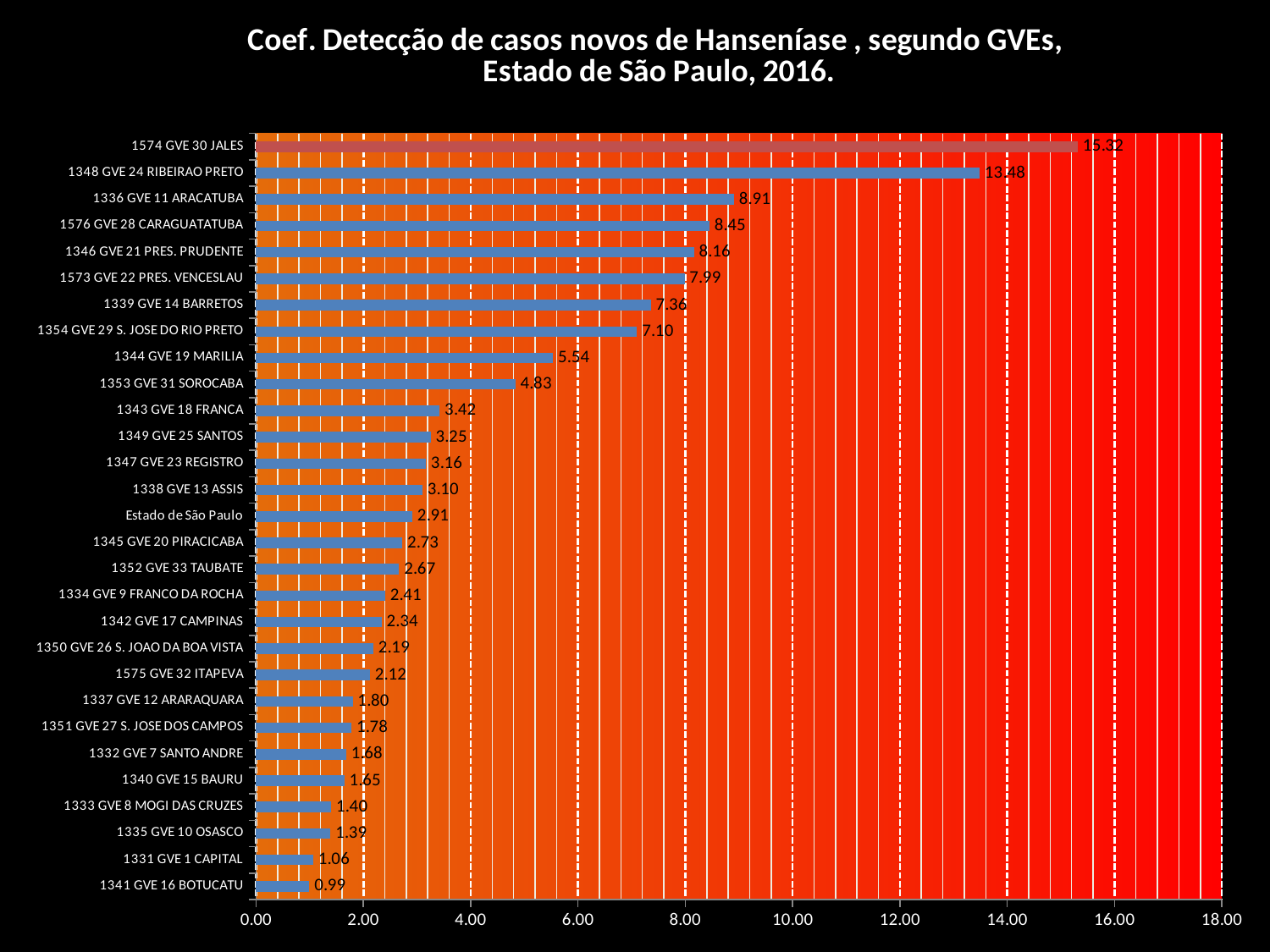
What is the value for 1574 GVE 30 JALES? 15.32 What kind of chart is shown on the slide? bar chart What is the value for Estado de São Paulo? 2.91 How many categories are shown in the chart? 29 Which category has the highest value? 1574 GVE 30 JALES Which category has the lowest value? 1341 GVE 16 BOTUCATU What is the difference between the values for 1574 GVE 30 JALES and 1348 GVE 24 RIBEIRAO PRETO? 1.84 Which is larger, the value for 1336 GVE 11 ARACATUBA or 1576 GVE 28 CARAGUATATUBA? 1336 GVE 11 ARACATUBA What is the difference between the values for 1331 GVE 1 CAPITAL and 1341 GVE 16 BOTUCATU? 0.07 What is the title of the chart? Coef. Detecção de casos novos de Hanseníase , segundo GVEs, Estado de São Paulo, 2016. What is the value for 1344 GVE 19 MARILIA? 5.54 Is the value for 1353 GVE 31 SOROCABA greater or less than 4.00? greater